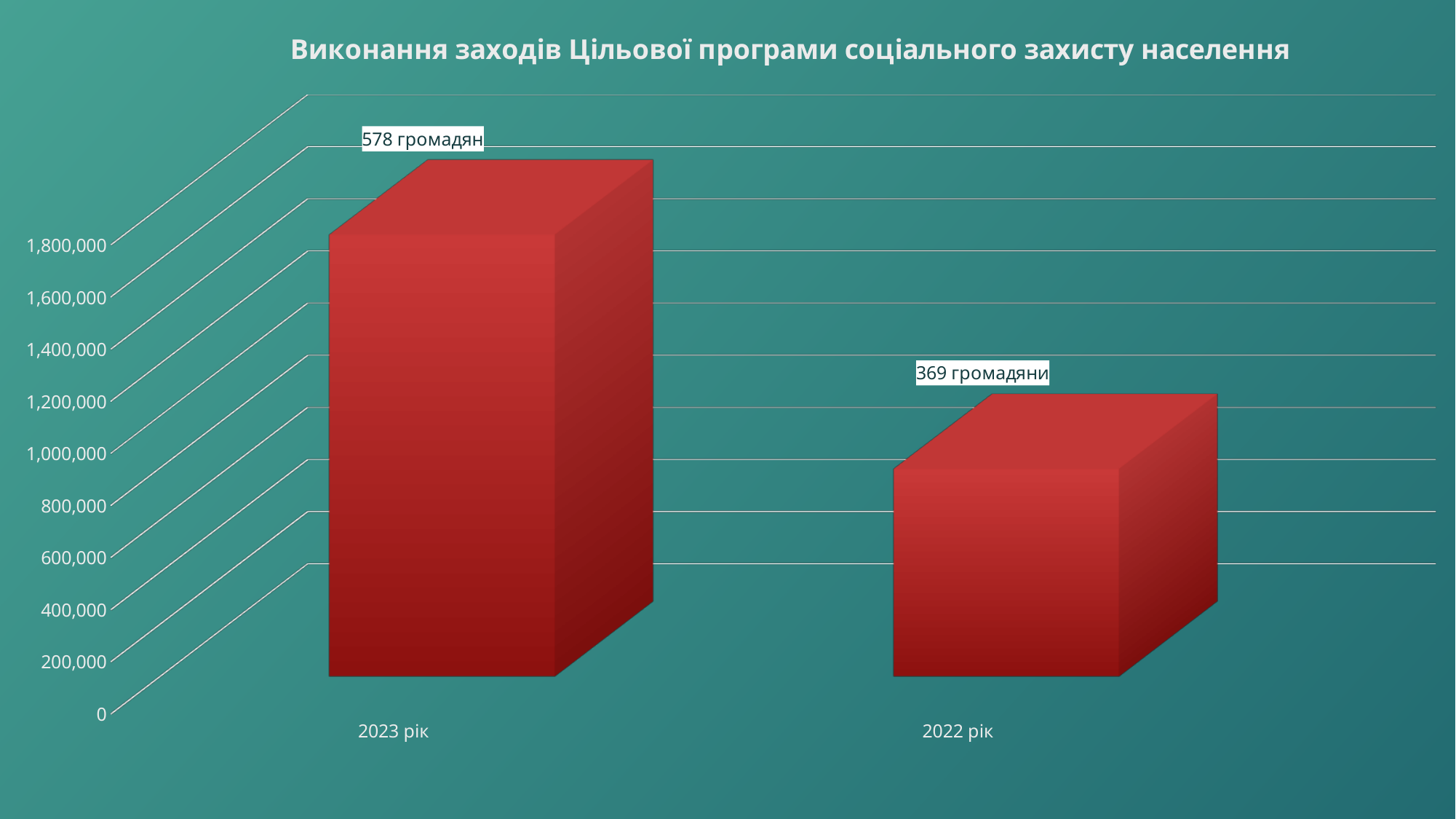
Which bar is taller, 2023 рік or 2022 рік? 2023 рік What kind of chart is shown on the slide? bar chart What label is printed above the 2023 рік bar? 578 громадян How many bars (categories) are plotted in the chart? 2 What is the title of the chart? Виконання заходів Цільової програми соціального захисту населення Is the value for 2023 рік greater or less than 1,000,000? greater Which category has the lowest bar? 2022 рік Which category has the highest bar? 2023 рік Is the value for 2022 рік greater or less than 1,400,000? less Do the bar values rise or fall moving from left to right along the x axis? fall Is the value for 2022 рік greater or less than 600,000? greater